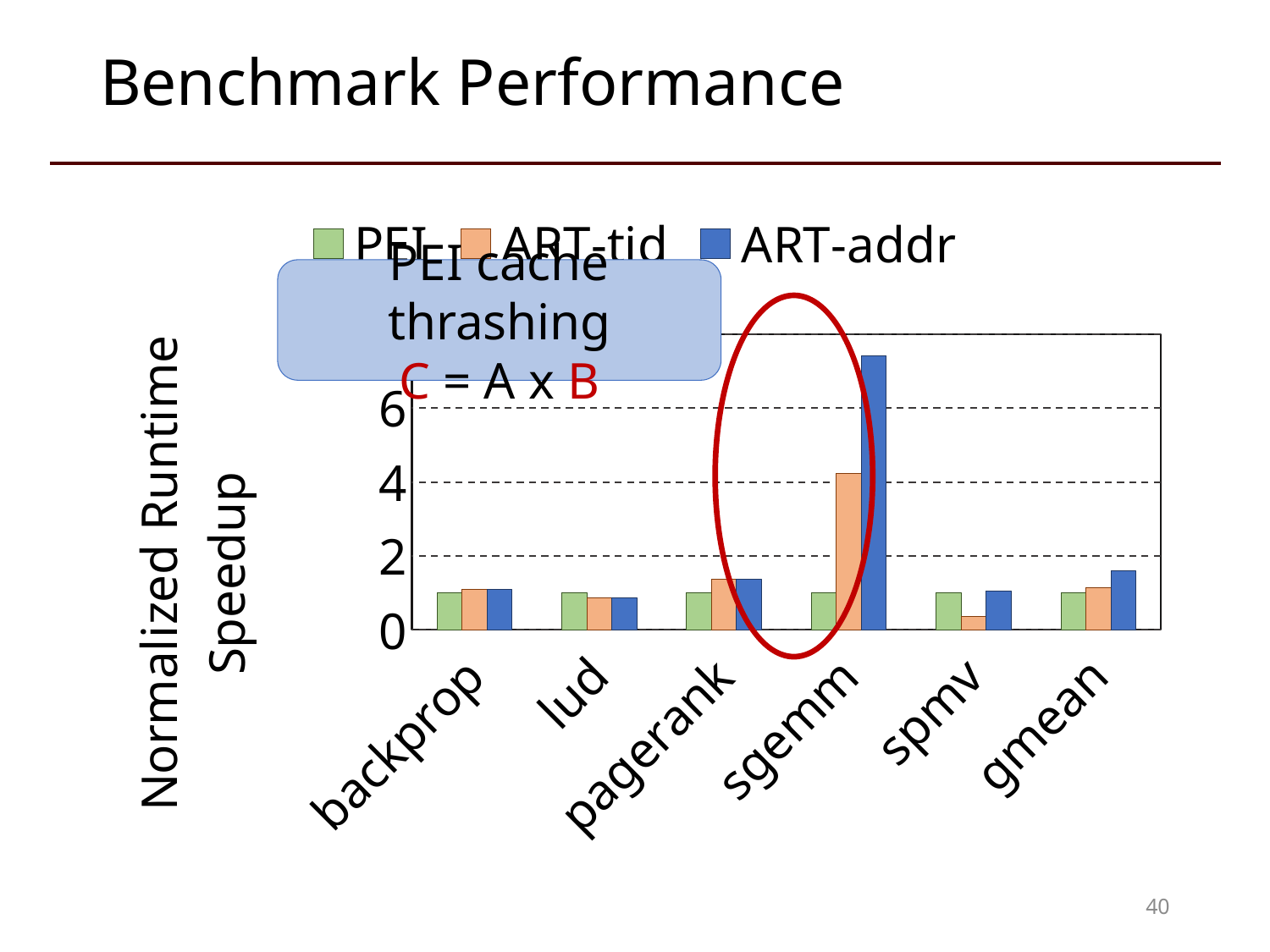
Is the ART-tid value for sgemm greater or less than 2? greater Which category has the highest ART-tid value? sgemm What kind of chart is shown on the slide? bar chart For spmv, which is larger: ART-tid or ART-addr? ART-addr What is the label on the y axis of the chart? Normalized Runtime Speedup How many benchmark categories are shown on the x axis? 6 Which category has the lowest ART-tid value? spmv Is the ART-tid value for spmv greater or less than 2? less Is the ART-addr value for sgemm greater or less than 6? greater How many series does the legend list? 3 For sgemm, which is larger: ART-tid or ART-addr? ART-addr Which category has the highest ART-addr value? sgemm